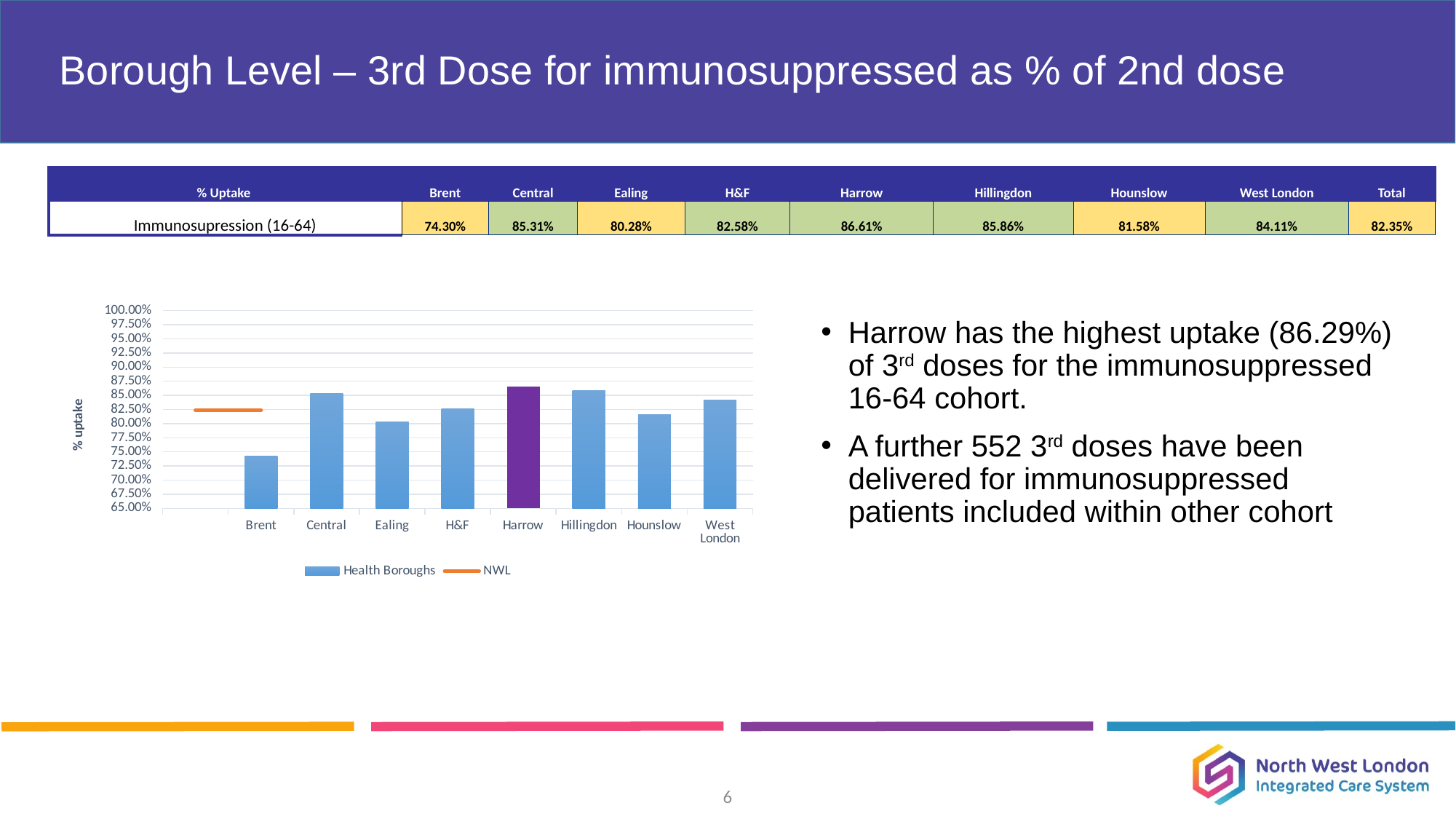
What kind of chart is shown on the slide? bar chart Is the bar for Harrow greater or less than 85.00%? greater According to the table, what is the % uptake for Hillingdon? 85.86% How many boroughs are plotted along the x axis of the chart? 8 Is the bar for Brent greater or less than 77.50%? less Which is larger, the bar for Central or the bar for Ealing? Central How many series does the chart legend list? 2 Which borough has the highest bar in the chart? Harrow According to the table, what is the difference in % uptake between Central and Brent? 11.01 percentage points What is the label on the chart's y axis? % uptake Is the bar for Hounslow greater or less than 80.00%? greater Which borough has the lowest bar in the chart? Brent